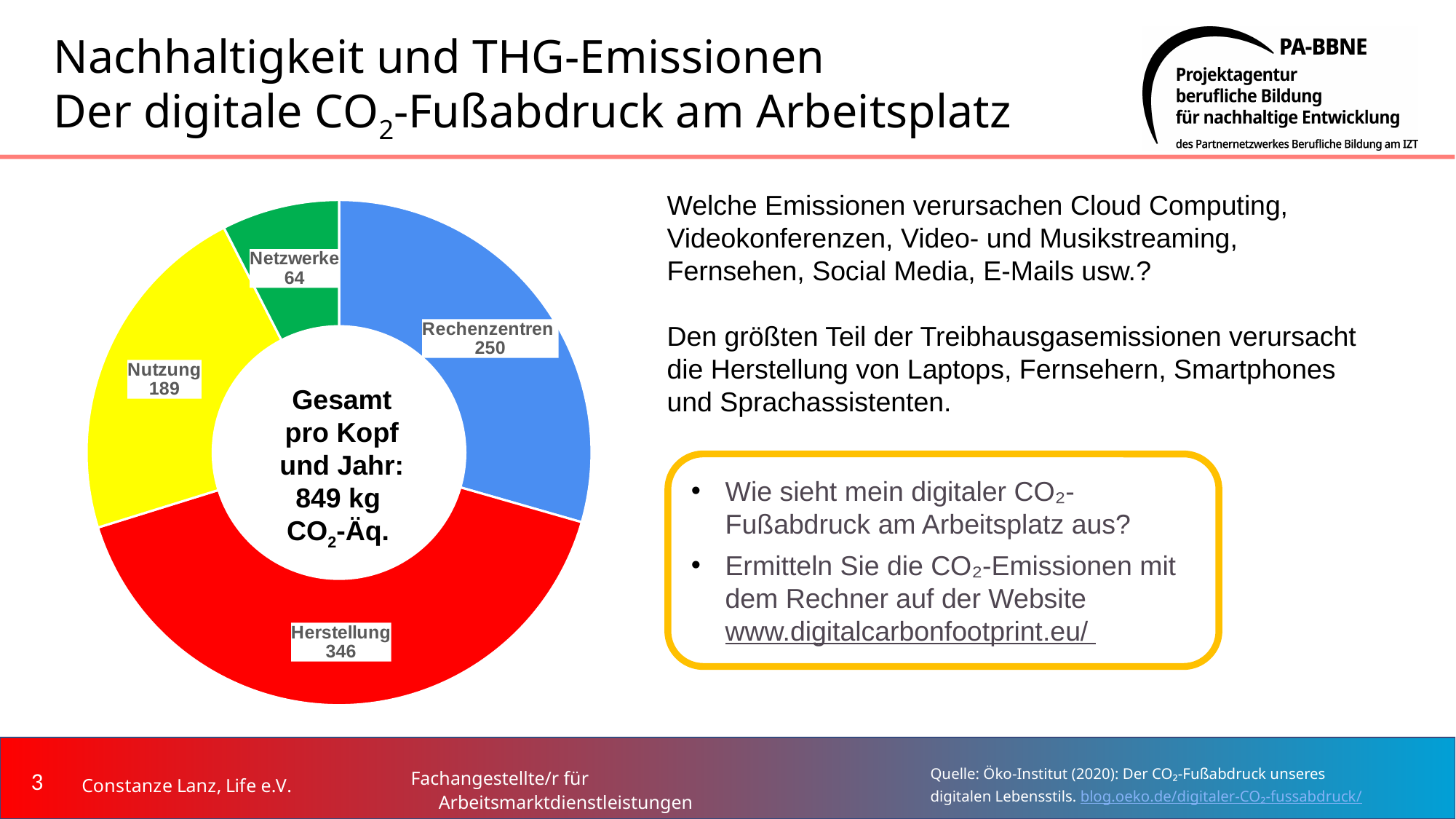
What colour is the Nutzung slice in the pie chart? Yellow What is the value for Herstellung in the pie chart? 346 Which is larger, the value for Rechenzentren or the value for Nutzung? Rechenzentren Which category has the largest slice in the pie chart? Herstellung What is the value for Rechenzentren in the pie chart? 250 What kind of chart is shown on the slide? Pie chart (doughnut) What total is printed in the centre of the pie chart? 849 kg CO2-Äq. Which category has the smallest slice in the pie chart? Netzwerke What is the value for Netzwerke in the pie chart? 64 What is the difference between the values for Nutzung and Netzwerke? 125 What is the difference between the values for Herstellung and Rechenzentren? 96 How many categories does the pie chart show? 4